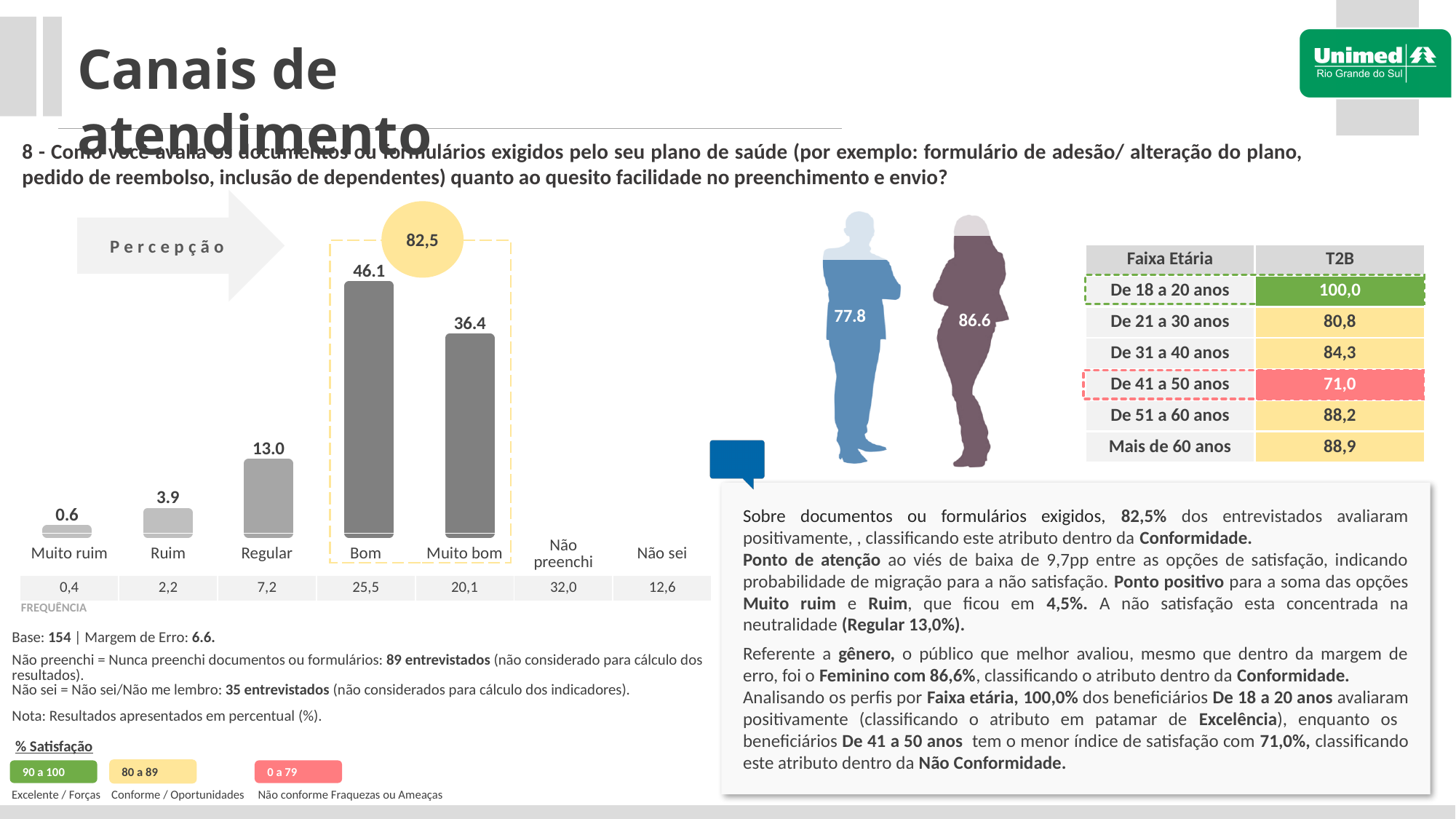
What is the value shown for the 'Regular' bar? 13.0 What is the difference between the 'Bom' and 'Muito bom' values? 9.7 How many categories are labelled along the x axis of the bar chart? 7 What is the sum of the 'Muito ruim' and 'Ruim' values? 4.5 What is the value shown for the 'Bom' bar? 46.1 What is the value shown for the 'Muito ruim' bar? 0.6 What is the value shown for the 'Muito bom' bar? 36.4 Which is larger, the value for 'Regular' or the value for 'Ruim'? Regular Which category with a plotted bar has the lowest value? Muito ruim What kind of chart is used to show the evaluation of documents and forms (Muito ruim to Muito bom)? bar chart Which category has the highest bar in the chart? Bom What is the combined value of 'Bom' and 'Muito bom' shown in the yellow circle above the chart? 82,5